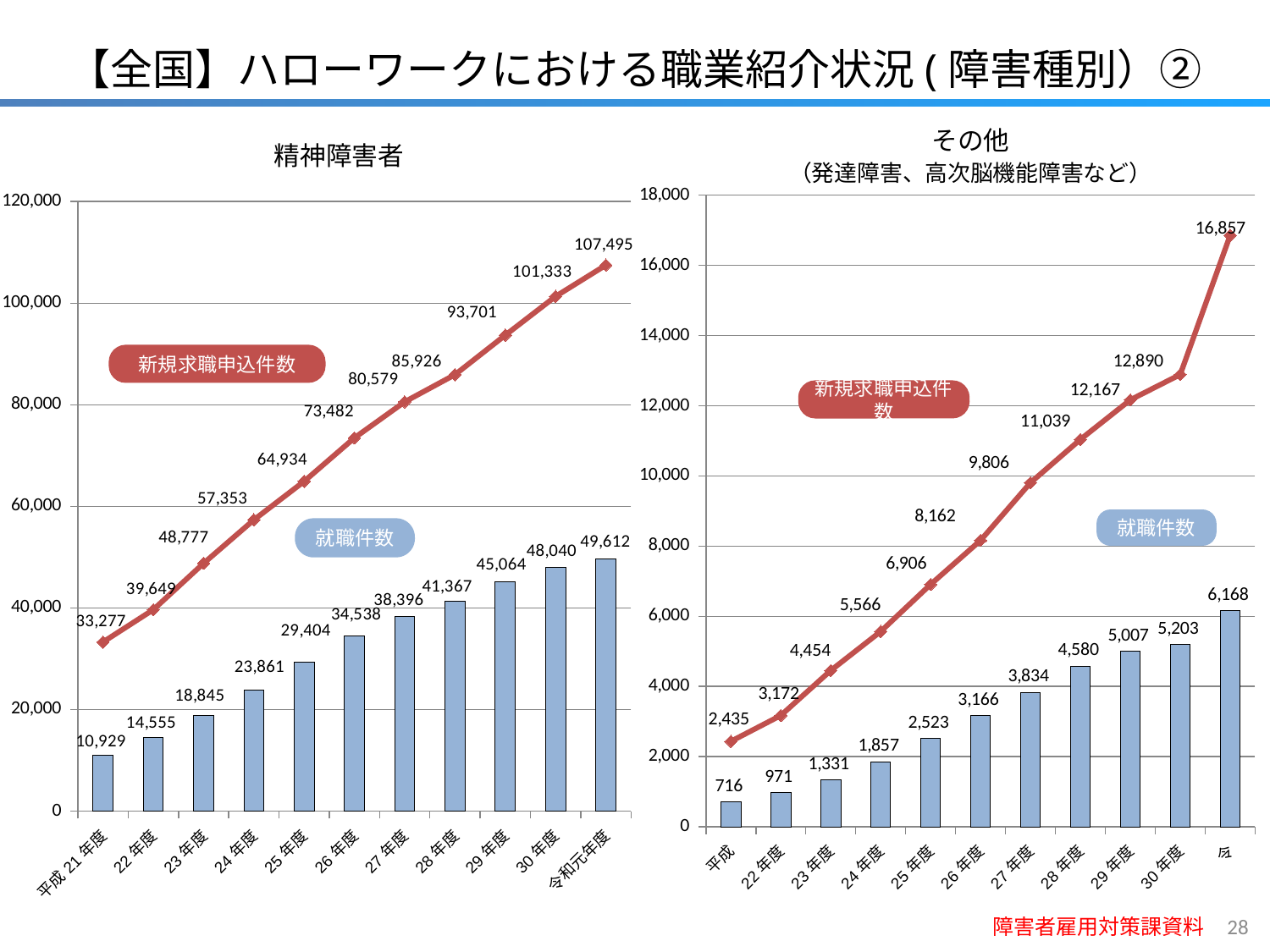
In the 精神障害者 chart, which year has the lowest 就職件数? 平成21年度 In the その他 chart, does the 新規求職申込件数 line rise or fall from 平成21年度 to 令和元年度? rise In the その他 chart, what is the 新規求職申込件数 value for 27年度? 9,806 How many years are shown on the x axis of the 精神障害者 chart? 11 What kind of chart is used for 就職件数 in the 精神障害者 chart? bar chart In the その他 chart, what is the difference in 就職件数 between 30年度 and 29年度? 196 In the その他 chart, which year has the highest 新規求職申込件数? 令和元年度 In the 精神障害者 chart, which is larger: the 就職件数 for 28年度 or the 就職件数 for 27年度? 28年度 In the 精神障害者 chart, what is the difference between the 新規求職申込件数 and 就職件数 values for 30年度? 53,293 In the その他 chart, what is the 就職件数 value for 22年度? 971 In the 精神障害者 chart, what is the 就職件数 value for 25年度? 29,404 In the 精神障害者 chart, what is the 新規求職申込件数 value for 令和元年度? 107,495